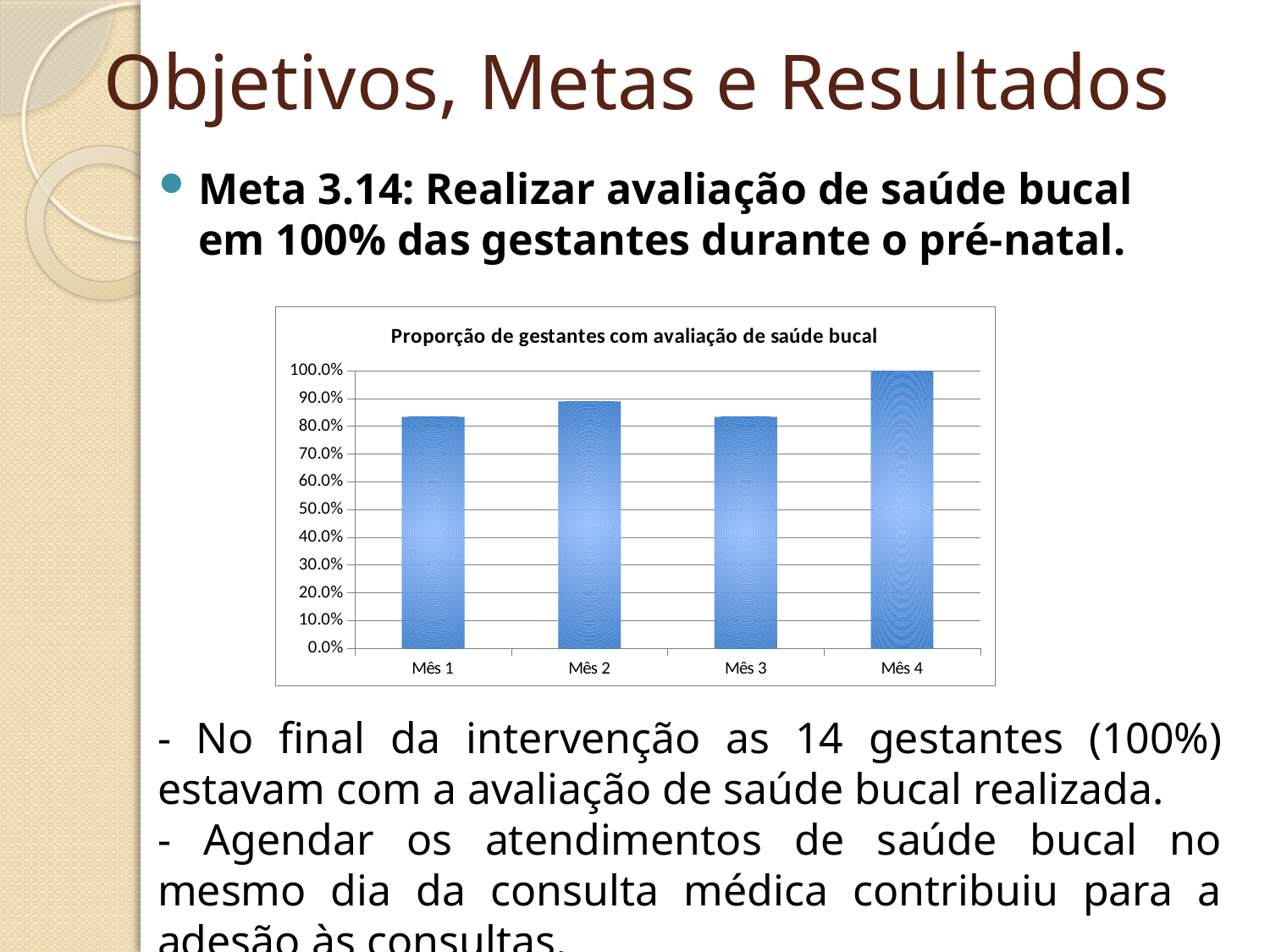
How many months (categories) are plotted on the x axis? 4 What is the value for Mês 4? 100.0% Is the value for Mês 1 greater or less than 90.0%? less Which month has the highest proportion of pregnant women with oral health evaluation? Mês 4 What kind of chart is shown on the slide? bar chart Which is larger, the value for Mês 2 or the value for Mês 1? Mês 2 Is the value for Mês 1 greater or less than 80.0%? greater Is the value for Mês 3 greater or less than 90.0%? less What is the title of the chart? Proporção de gestantes com avaliação de saúde bucal Does the value rise or fall from Mês 3 to Mês 4? rise Which is larger, the value for Mês 4 or the value for Mês 3? Mês 4